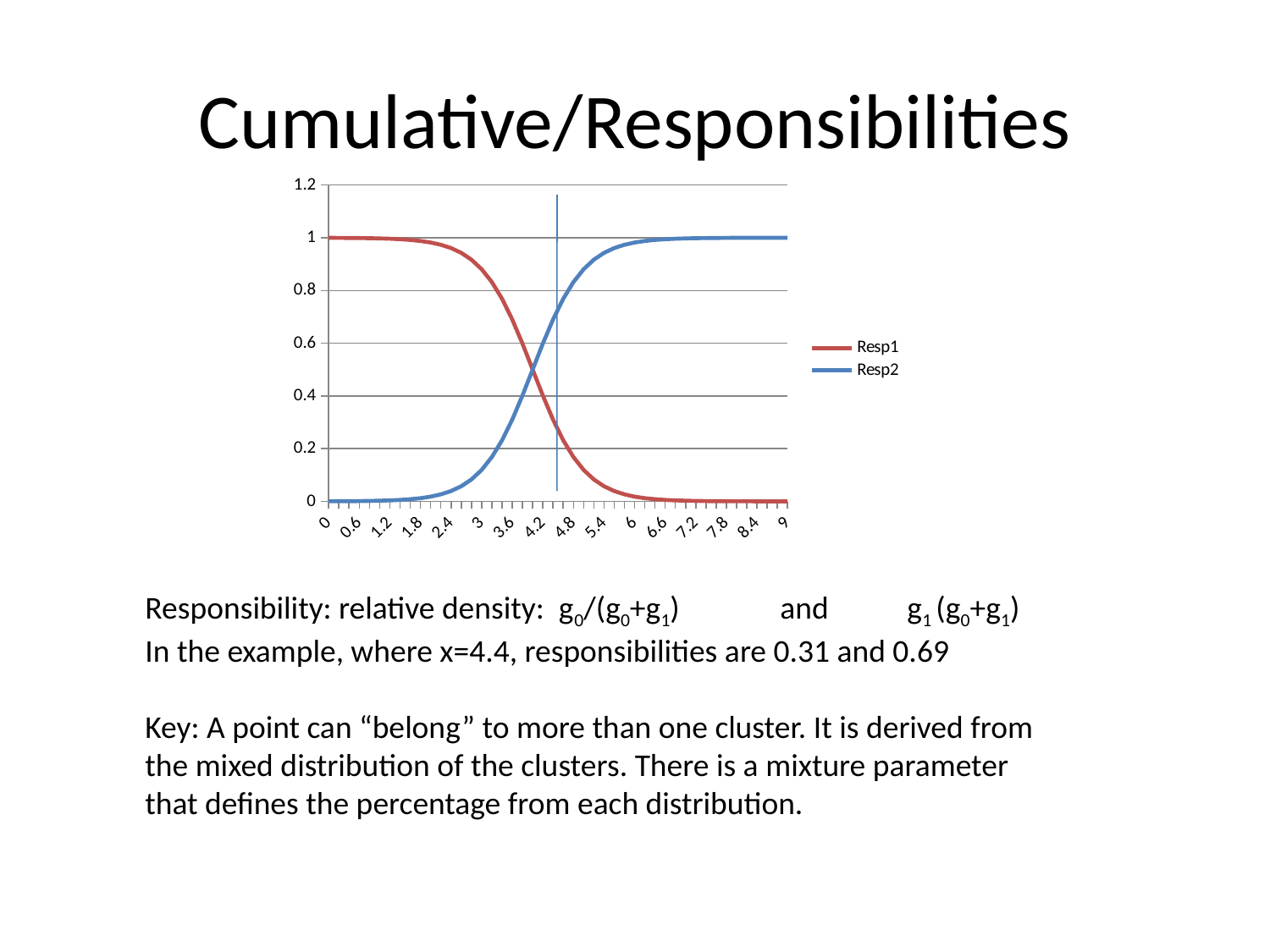
Is the value of Resp2 at x=6 greater or less than 0.8? greater What are the two series names shown in the chart legend? Resp1 and Resp2 How many series does the chart's legend list? 2 At x=1.2, which series has the larger value, Resp1 or Resp2? Resp1 At x=6, which series has the larger value, Resp1 or Resp2? Resp2 Is the value of Resp1 at x=0 greater or less than 0.8? greater Is the value of Resp1 at x=9 greater or less than 0.2? less What kind of chart is shown on the slide? line chart Does the Resp2 line rise or fall as x increases along the x axis? rise What colour is the Resp1 line in the chart? red Does the Resp1 line rise or fall as x increases along the x axis? fall